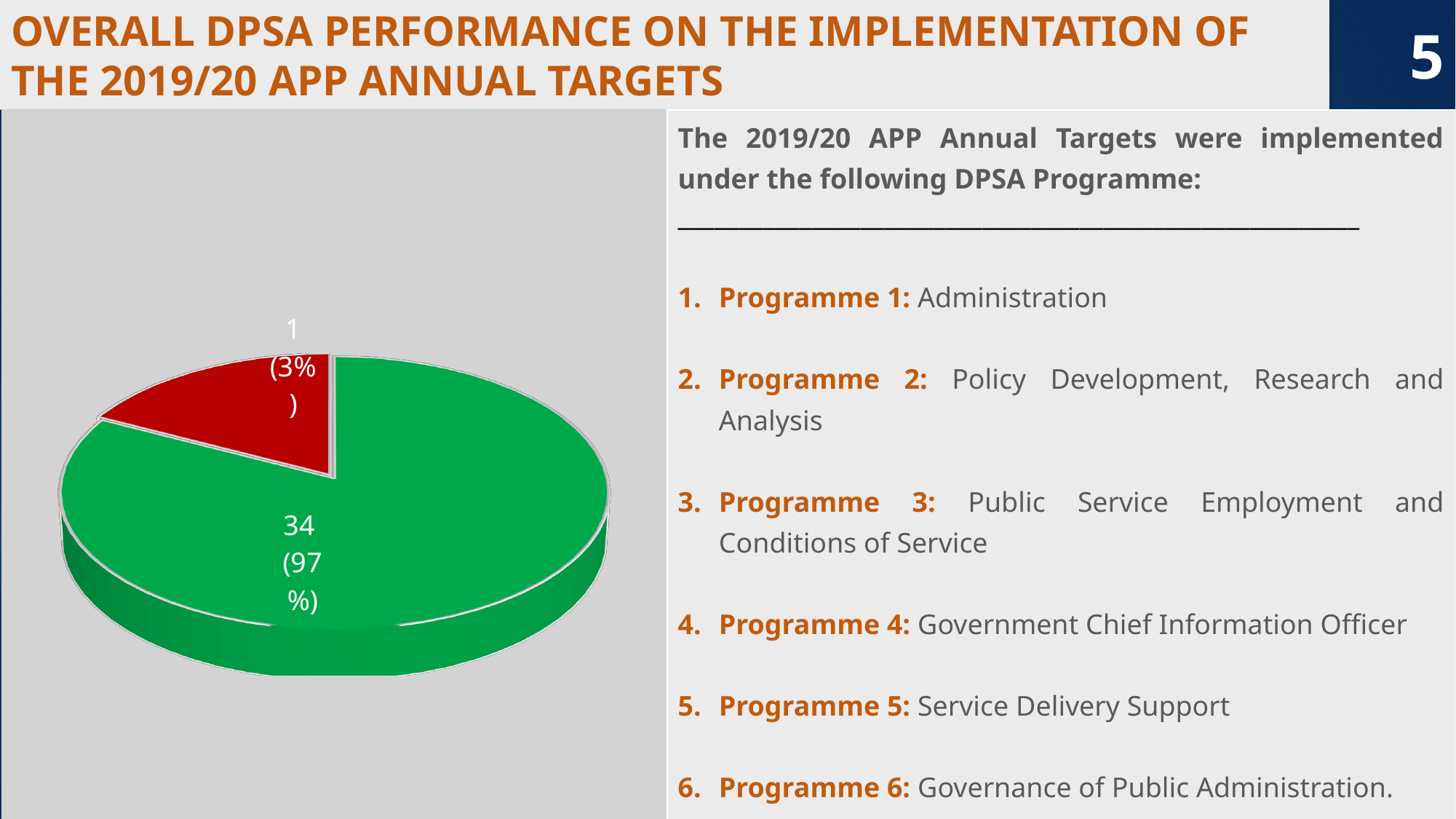
What percentage share does the green slice of the pie chart represent? 97% Which slice of the pie chart is the smallest, the green one or the red one? the red one How many slices does the pie chart have? 2 What value is labelled on the red slice of the pie chart? 1 What percentage share does the red slice of the pie chart represent? 3% Which slice of the pie chart is the largest, the green one or the red one? the green one What kind of chart is shown on the slide? pie chart Is the value of the green slice larger or smaller than the value of the red slice? larger What is the difference between the values of the green slice and the red slice in the pie chart? 33 What two colours are used for the slices of the pie chart? green and red What value is labelled on the green slice of the pie chart? 34 What is the total of the values shown on the two slices of the pie chart? 35